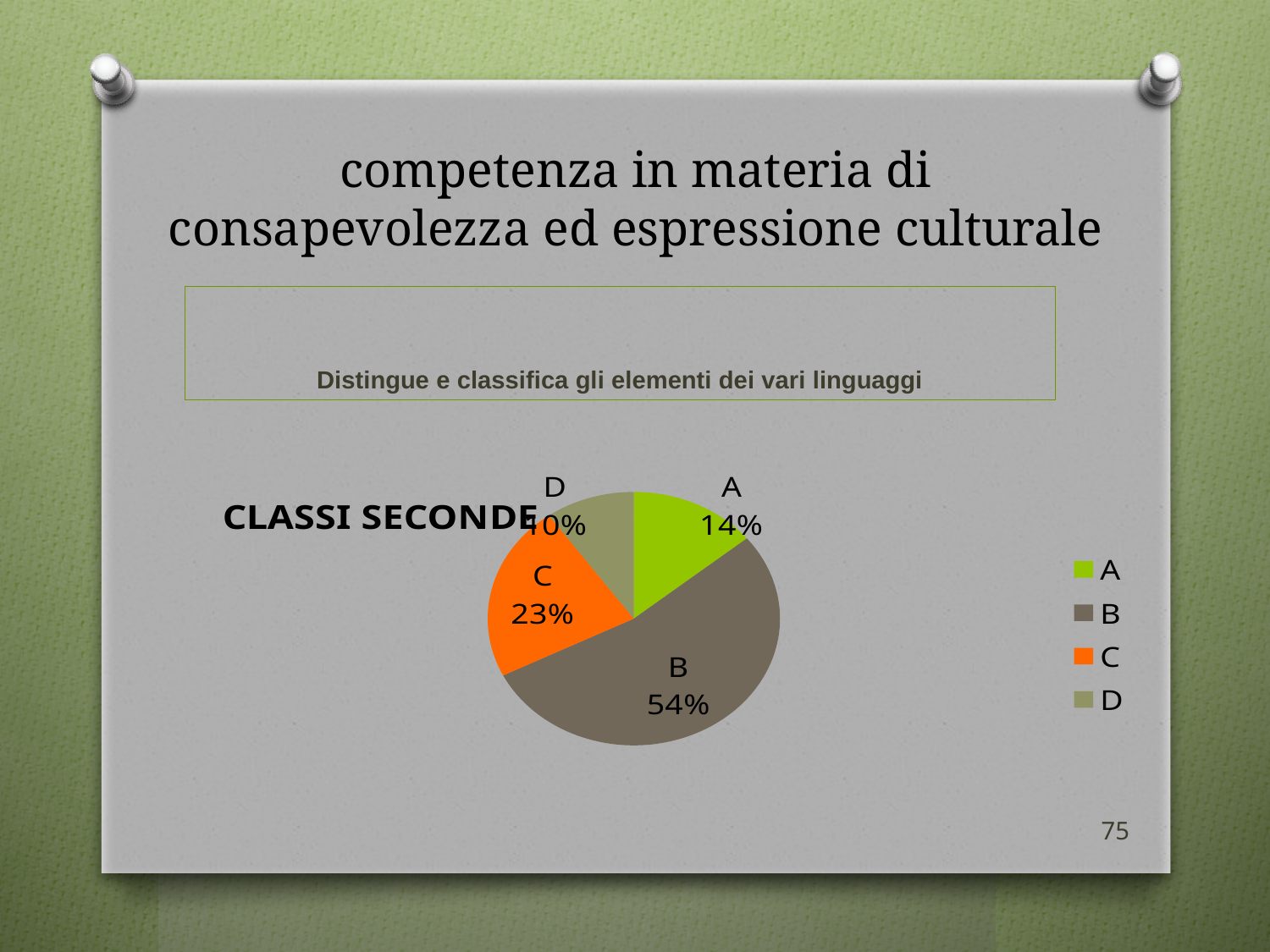
Which category has the largest slice of the pie? B What is the difference in percentage points between slice B and slice A? 40% What percentage does slice B represent in the pie chart? 54% Which is larger, the slice for C or the slice for A? C What percentage does slice C represent in the pie chart? 23% What percentage does slice A represent in the pie chart? 14% Which category has the smallest slice of the pie? D What colour is used for category C in the pie chart? orange How many categories does the legend list? 4 What is the title of the chart? CLASSI SECONDE What is the difference in percentage points between slice B and slice C? 31% What kind of chart is shown on the slide? pie chart